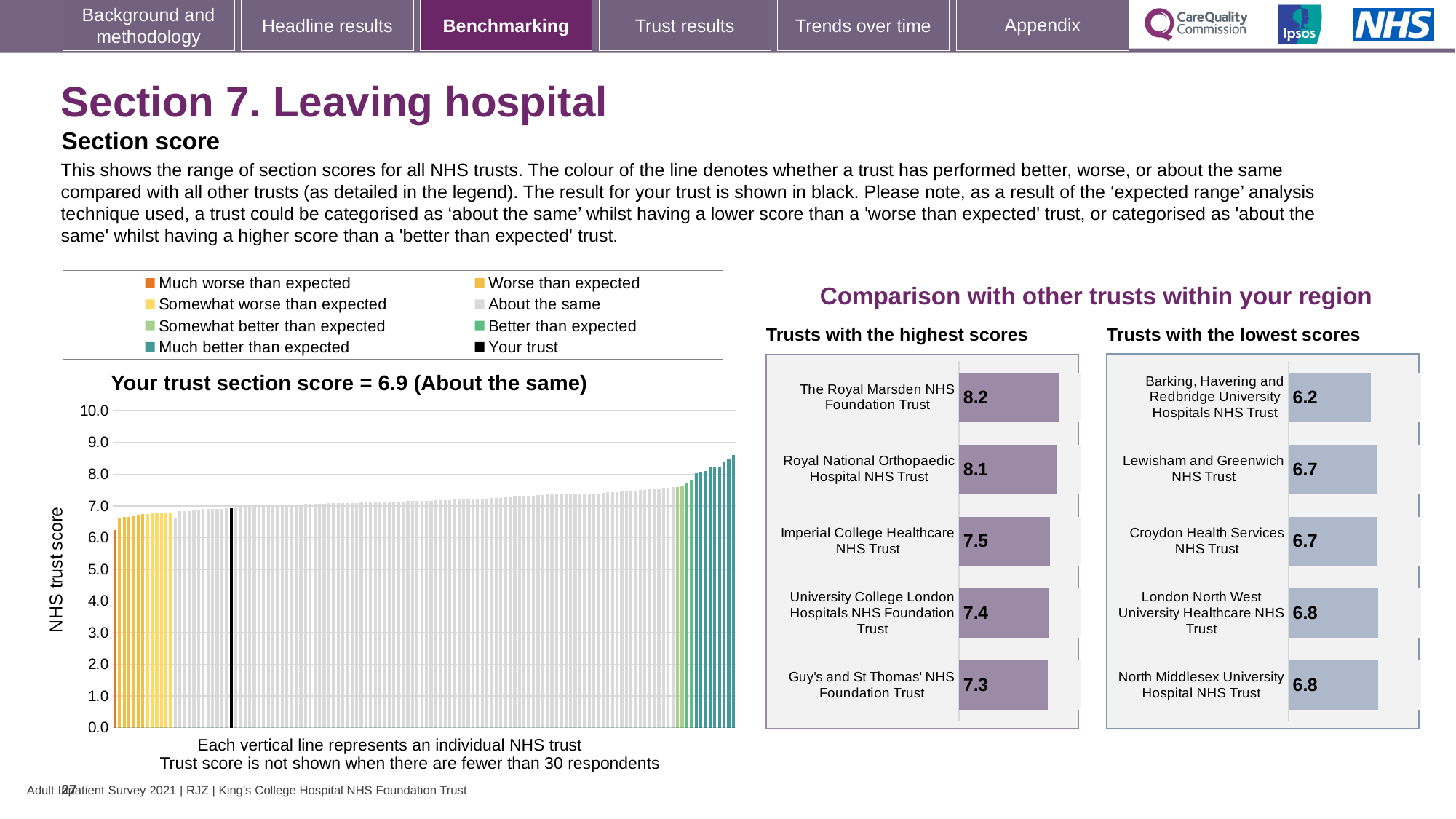
On the 'Trusts with the lowest scores' chart, what is the difference between the scores of North Middlesex University Hospital NHS Trust and Barking, Havering and Redbridge University Hospitals NHS Trust? 0.6 On the 'Trusts with the highest scores' chart, which trust has the lowest score shown? Guy's and St Thomas' NHS Foundation Trust On the 'Trusts with the highest scores' chart, which has the higher score: Royal National Orthopaedic Hospital NHS Trust or University College London Hospitals NHS Foundation Trust? Royal National Orthopaedic Hospital NHS Trust On the 'Trusts with the highest scores' chart, what is the difference between the scores of The Royal Marsden NHS Foundation Trust and Guy's and St Thomas' NHS Foundation Trust? 0.9 On the 'Trusts with the lowest scores' chart, which trust has the lowest score? Barking, Havering and Redbridge University Hospitals NHS Trust How many trusts are shown on the 'Trusts with the lowest scores' chart? 5 On the 'Trusts with the lowest scores' chart, what is the score for Barking, Havering and Redbridge University Hospitals NHS Trust? 6.2 On the 'Trusts with the highest scores' chart, what is the score for Imperial College Healthcare NHS Trust? 7.5 On the main chart of all NHS trusts on the left, what is the section score for your trust? 6.9 What kind of chart is the main chart of all NHS trusts on the left of the slide? Bar chart On the 'Trusts with the highest scores' chart, what is the score for The Royal Marsden NHS Foundation Trust? 8.2 On the 'Trusts with the lowest scores' chart, what is the score for Lewisham and Greenwich NHS Trust? 6.7